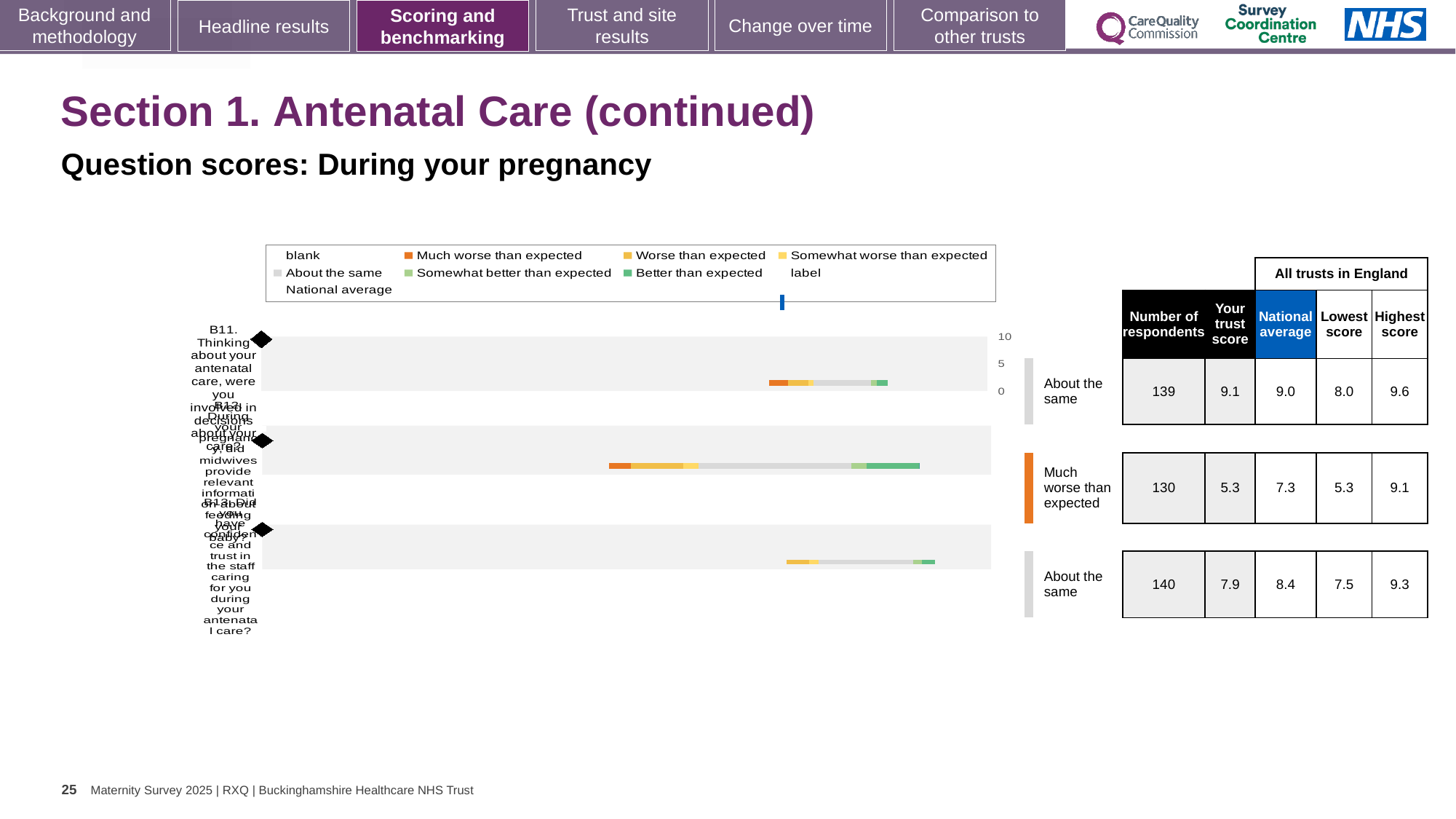
Which row of the table has the lowest 'Your trust score'? second row (B12), 5.3 What benchmark category label is shown next to the second bar (B12)? Much worse than expected How many question bars (B11, B12, B13) are plotted in the chart? 3 What kind of chart is shown on the slide? bar chart In the table beside the chart, what is the national average for the third row (B13)? 8.4 For the second row (B12), what is the difference between the national average and 'Your trust score'? 2.0 In the table beside the chart, what is 'Your trust score' for the second row (B12)? 5.3 What is the highest value shown on the chart's axis? 10 In the chart legend, what colour represents 'Better than expected'? green In the chart legend, what colour represents 'Much worse than expected'? orange In the table beside the chart, what is the number of respondents for the first row (B11)? 139 Which row of the table has the highest 'Your trust score'? first row (B11), 9.1